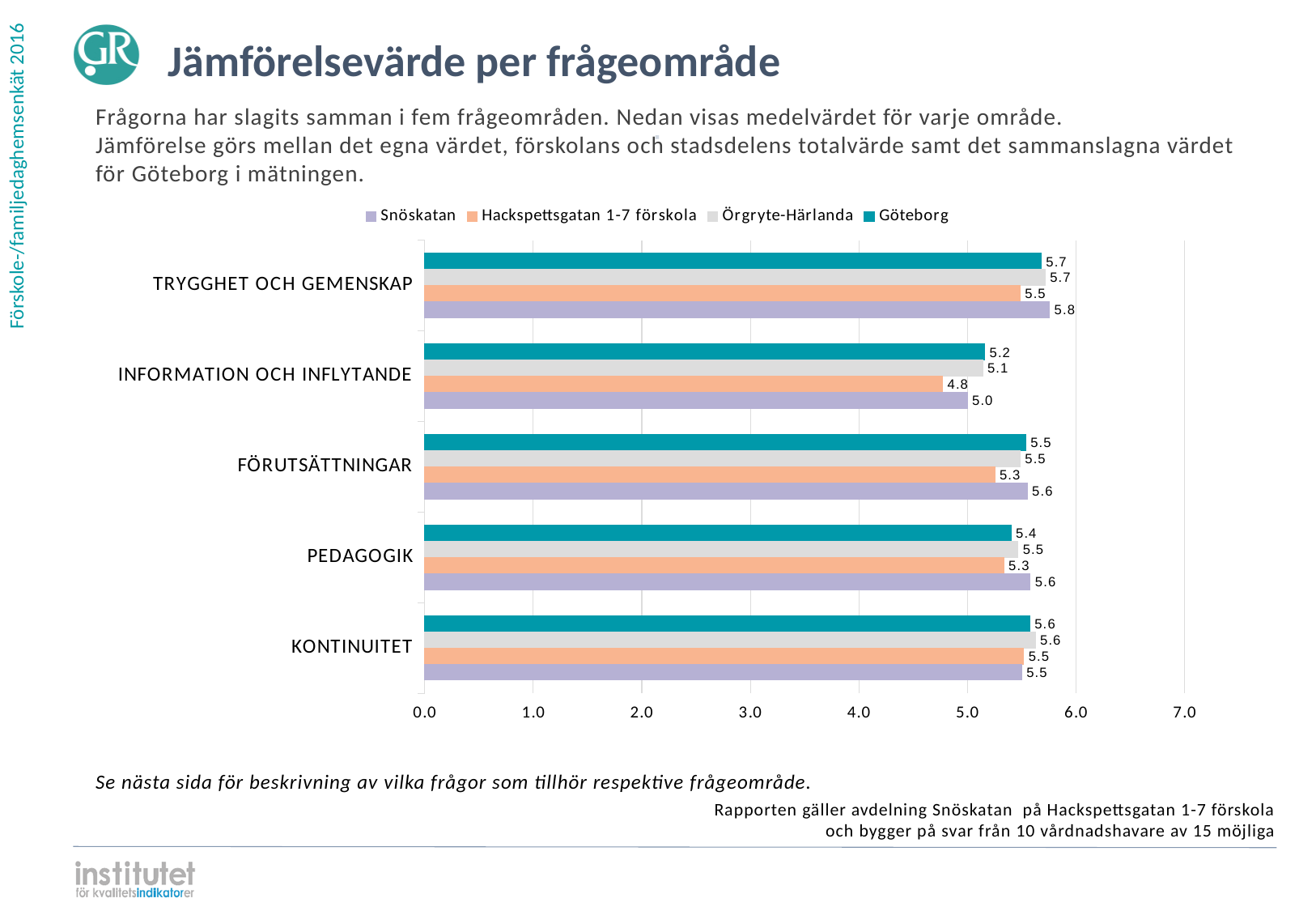
In the INFORMATION OCH INFLYTANDE category, which is larger: the value for Göteborg or the value for Snöskatan? Göteborg What is the value for Hackspettsgatan 1-7 förskola in the INFORMATION OCH INFLYTANDE category? 4.8 What kind of chart is shown on the slide? Bar chart What is the value for Snöskatan in the TRYGGHET OCH GEMENSKAP category? 5.8 What is the value for Göteborg in the PEDAGOGIK category? 5.4 How many categories are shown on the chart? 5 In which category does Snöskatan have its highest value? TRYGGHET OCH GEMENSKAP What is the value for Örgryte-Härlanda in the KONTINUITET category? 5.6 What is the difference between the Snöskatan value and the Hackspettsgatan 1-7 förskola value in the FÖRUTSÄTTNINGAR category? 0.3 In which category does Snöskatan have its lowest value? INFORMATION OCH INFLYTANDE Which series is shown in teal in the legend? Göteborg How many series does the legend list? 4